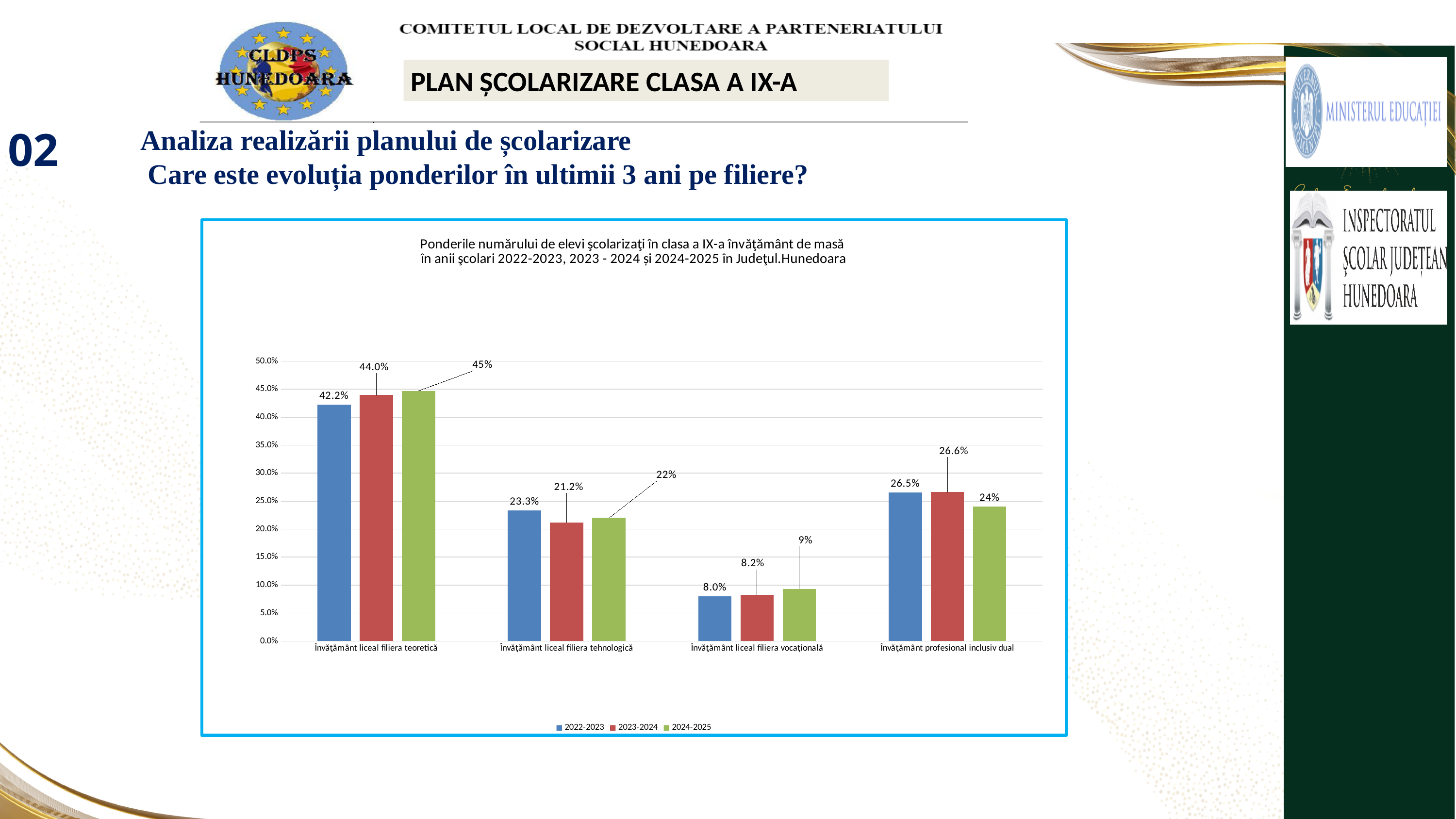
What kind of chart is shown on the slide? bar chart How many series does the legend list? 3 Which is larger for Învăţământ profesional inclusiv dual: the 2022-2023 value or the 2024-2025 value? 2022-2023 What is the value for Învăţământ liceal filiera vocaţională in 2024-2025? 9% Which category has the lowest value in 2022-2023? Învăţământ liceal filiera vocaţională What is the value for Învăţământ liceal filiera tehnologică in 2023-2024? 21.2% What is the value for Învăţământ profesional inclusiv dual in 2023-2024? 26.6% How many categories are shown on the x axis? 4 What is the difference between the 2023-2024 and 2022-2023 values for Învăţământ liceal filiera teoretică? 1.8% What is the value for Învăţământ liceal filiera teoretică in 2022-2023? 42.2% Do the values for Învăţământ liceal filiera teoretică rise or fall from 2022-2023 to 2024-2025? rise Which category has the highest value in 2024-2025? Învăţământ liceal filiera teoretică